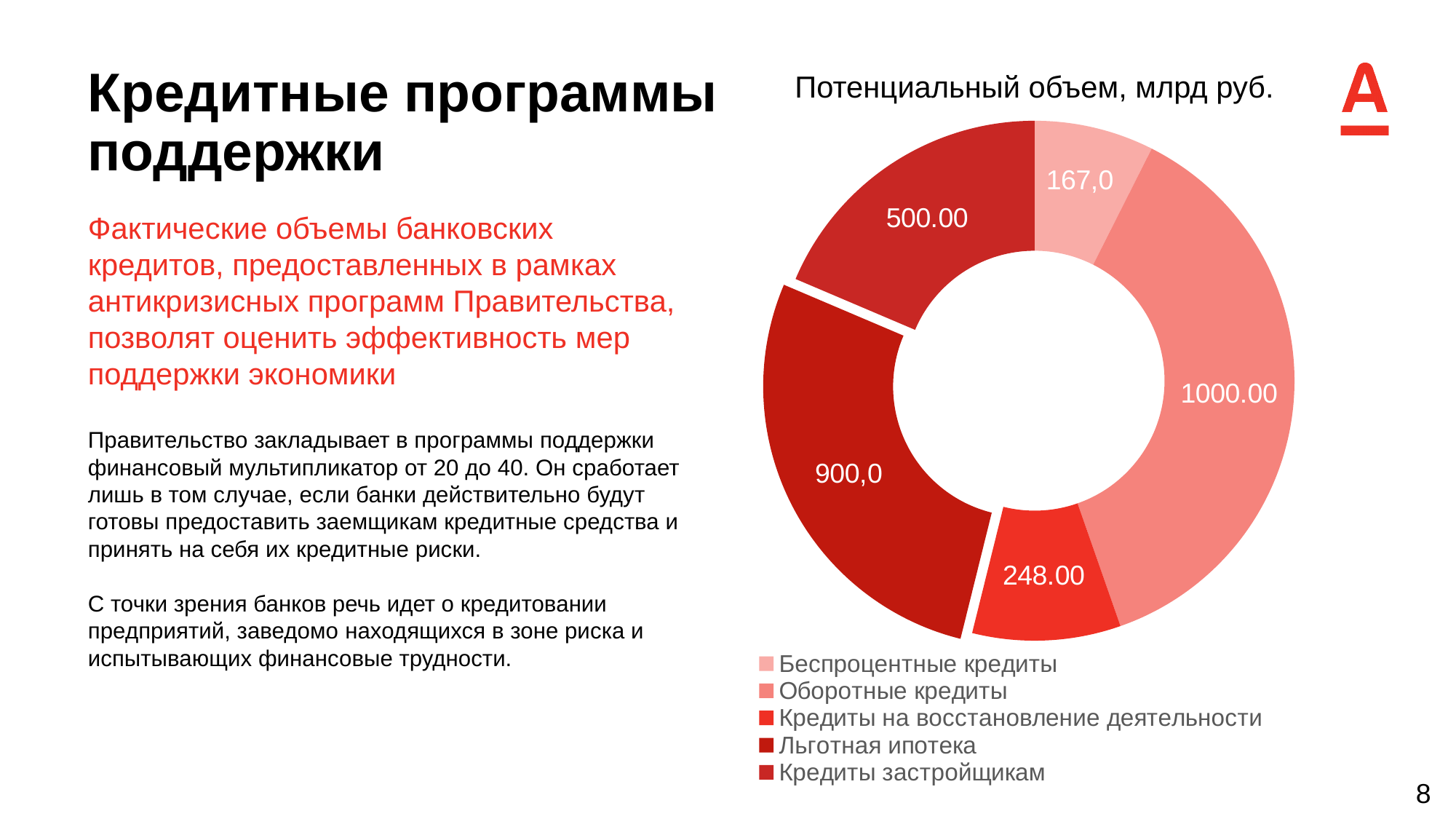
What is the value for Беспроцентные кредиты? 167,0 Which category has the highest value? Оборотные кредиты What is the title of the chart? Потенциальный объем, млрд руб. Which is larger, the value for Кредиты застройщикам or the value for Кредиты на восстановление деятельности? Кредиты застройщикам What kind of chart is shown on the slide? doughnut chart What is the value for Кредиты застройщикам? 500.00 What is the value for Оборотные кредиты? 1000.00 What is the value for Льготная ипотека? 900,0 What is the difference between the values for Оборотные кредиты and Льготная ипотека? 100 What is the value for Кредиты на восстановление деятельности? 248.00 Which category has the lowest value? Беспроцентные кредиты How many categories does the chart show? 5